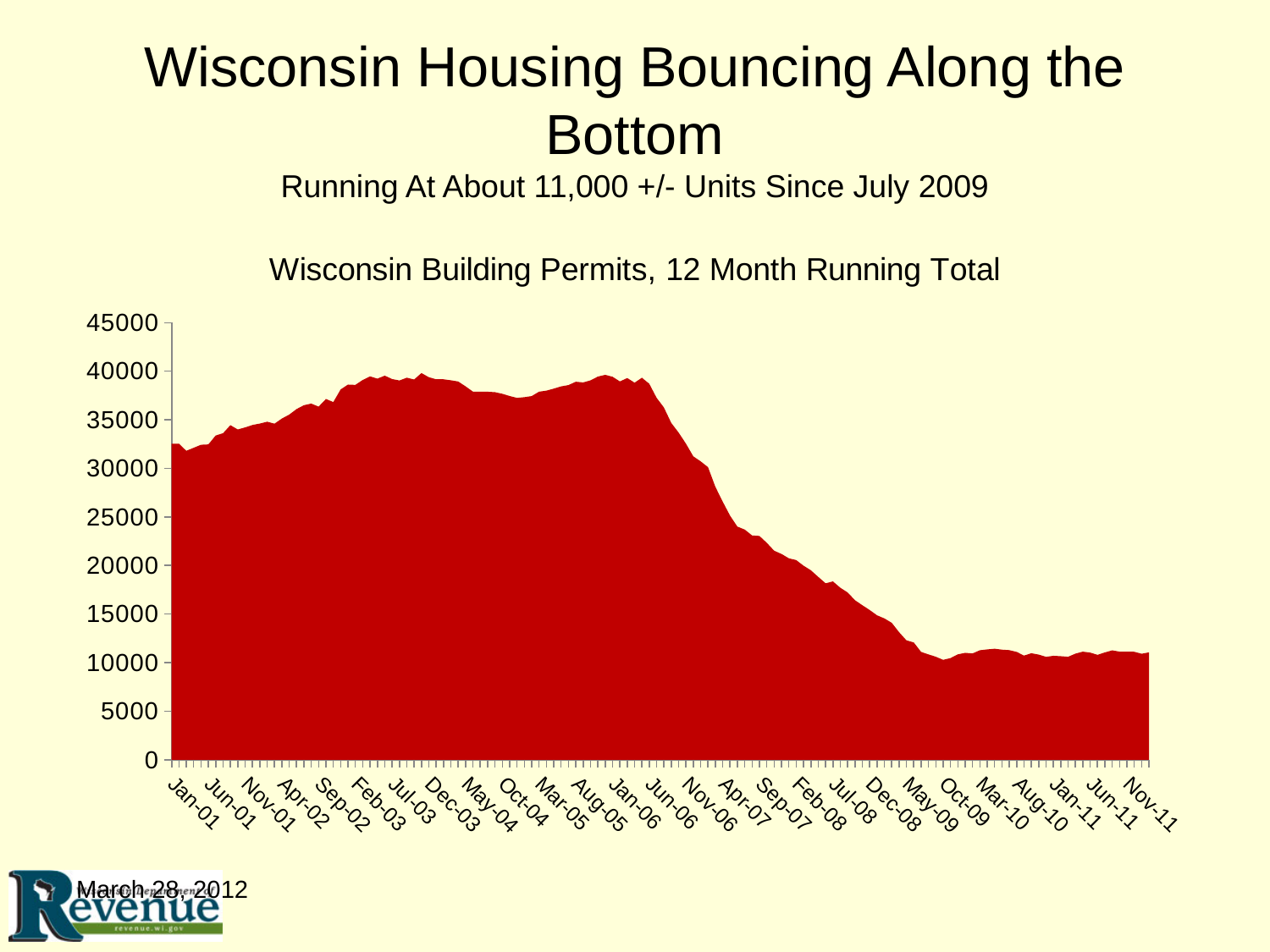
Is the value for May-09 greater or less than 15000? less What is the title of the chart? Wisconsin Building Permits, 12 Month Running Total Is the value for Jan-01 greater or less than 30000? greater Is the value for Jul-03 greater or less than 35000? greater What kind of chart is shown on the slide? Area chart Do the values rise or fall between Jun-06 and Dec-08? fall Which is larger, the value for Jan-01 or the value for Nov-11? Jan-01 Which is larger, the value for Jul-03 or the value for Apr-07? Jul-03 What is the highest value shown on the vertical axis? 45000